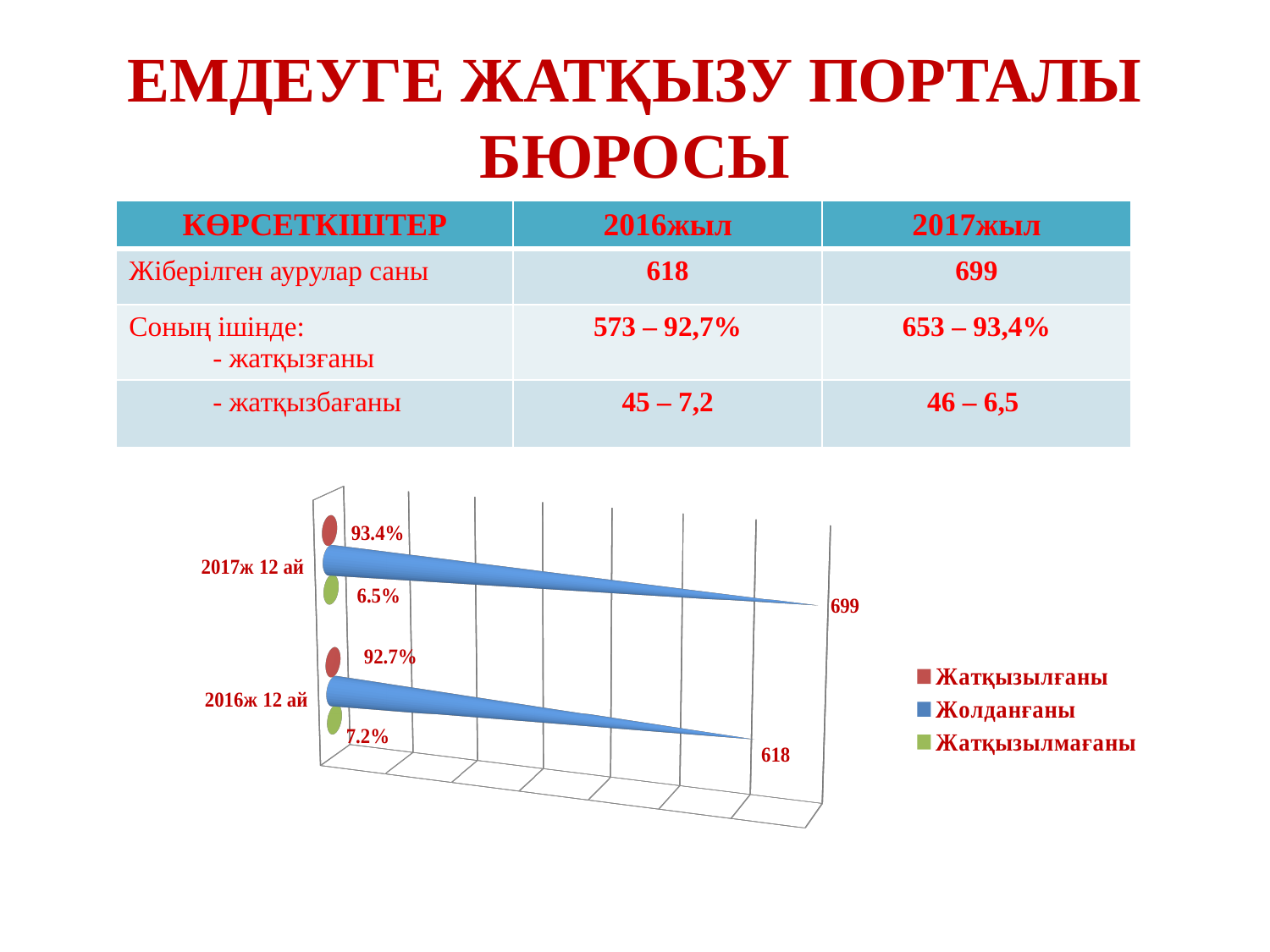
Which series in the chart is shown in blue? Жолданғаны What kind of chart is shown on the slide? bar chart How many categories are shown in the chart? 2 How many series does the chart legend list? 3 Which category has the higher Жолданғаны value in the chart, 2016ж 12 ай or 2017ж 12 ай? 2017ж 12 ай What is the value of the Жатқызылмағаны series for 2017ж 12 ай in the chart? 6.5% What is the value of the Жатқызылғаны series for 2017ж 12 ай in the chart? 93.4% What is the value of the Жолданғаны series for 2016ж 12 ай in the chart? 618 What is the value of the Жатқызылғаны series for 2016ж 12 ай in the chart? 92.7% What is the value of the Жатқызылмағаны series for 2016ж 12 ай in the chart? 7.2% What is the value of the Жолданғаны series for 2017ж 12 ай in the chart? 699 What is the difference between the Жолданғаны values for 2017ж 12 ай and 2016ж 12 ай in the chart? 81